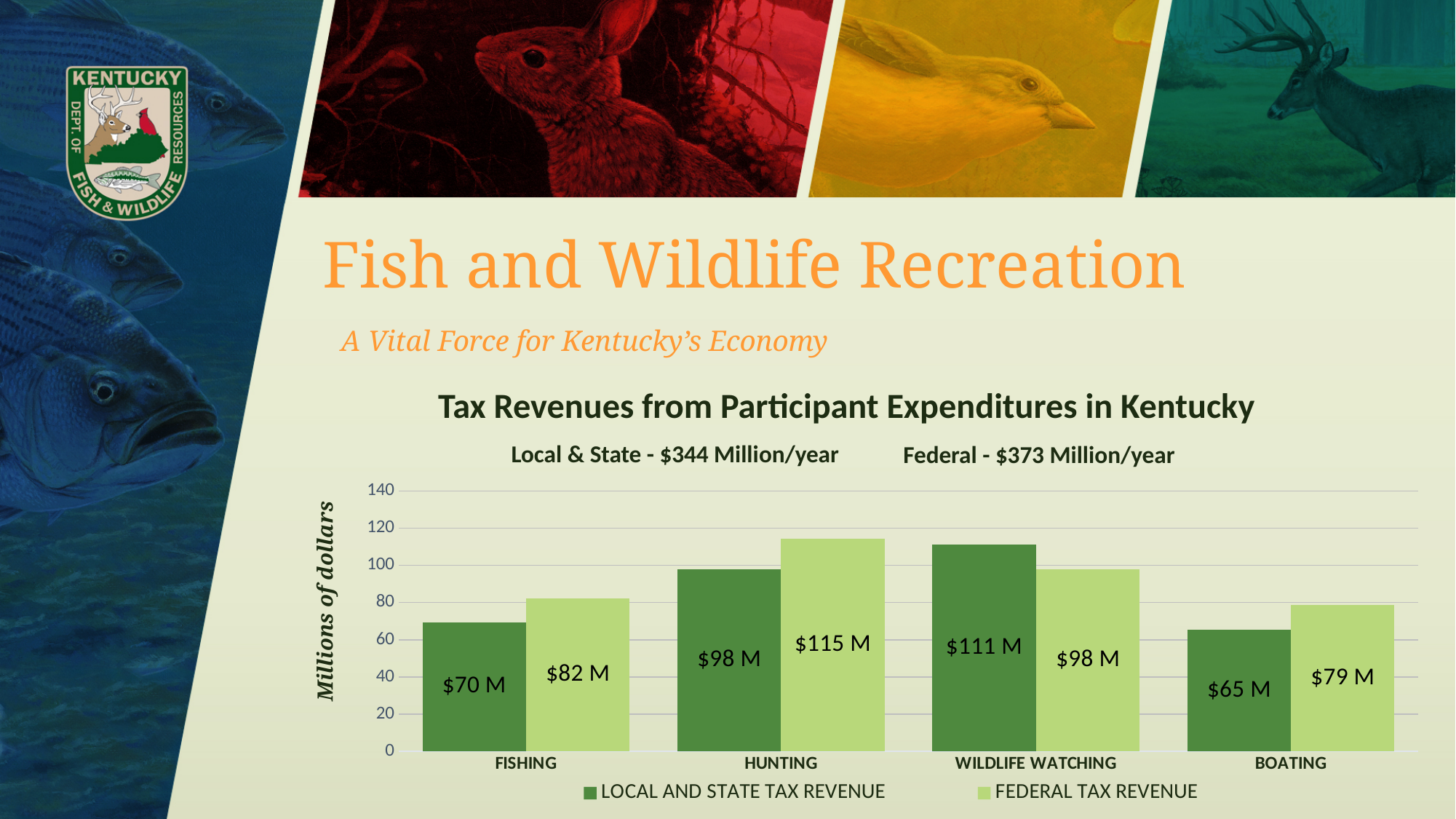
Which is larger for Wildlife Watching: local and state tax revenue or federal tax revenue? Local and state tax revenue How many categories are shown on the x axis? 4 What is the federal tax revenue for Hunting? $115 M What is the federal tax revenue for Boating? $79 M What is the local and state tax revenue for Wildlife Watching? $111 M What is the difference between the federal and the local and state tax revenue for Fishing? $12 M Which category has the lowest local and state tax revenue? Boating What is the local and state tax revenue for Fishing? $70 M How many series does the legend list? 2 What kind of chart is shown? Bar chart What is the title of the chart? Tax Revenues from Participant Expenditures in Kentucky Which category has the highest federal tax revenue? Hunting